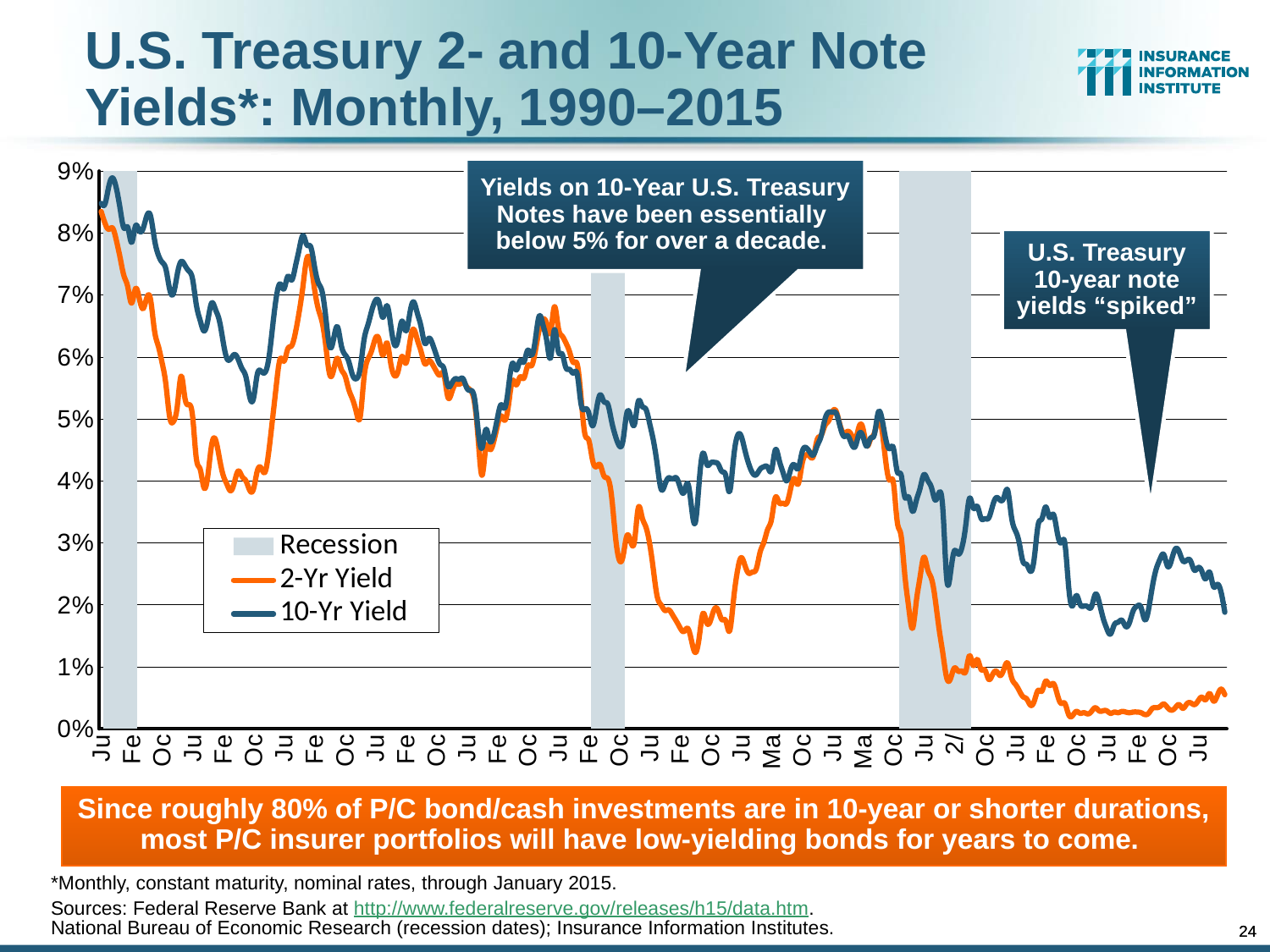
How many recession periods are shaded on the chart? 3 At the right end of the chart, is the 2-Yr Yield greater or less than 1%? less At the right end of the chart, which series is higher, the 2-Yr Yield or the 10-Yr Yield? 10-Yr Yield Is the lowest value reached by the 10-Yr Yield on the chart greater or less than 2%? less What is the title of the chart on the slide? U.S. Treasury 2- and 10-Year Note Yields*: Monthly, 1990–2015 What kind of chart is shown on the slide? line chart Is the highest value reached by the 2-Yr Yield on the chart greater or less than 7%? greater Overall, do Treasury yields rise or fall from the left of the chart (1990) to the right (2015)? fall What do the grey shaded bands on the chart represent? Recession How many entries does the chart's legend list? 3